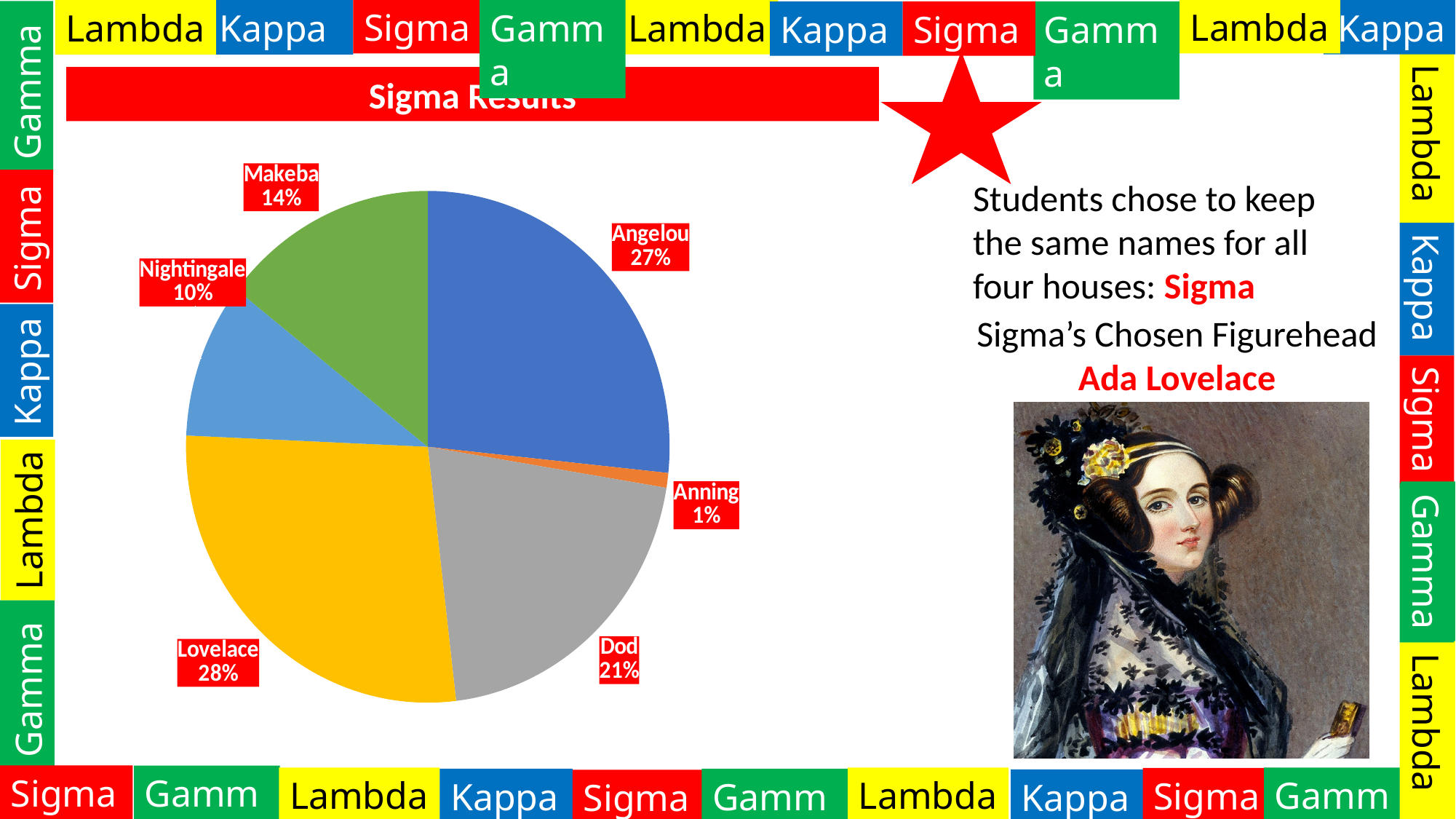
What is the title of the chart? Sigma Results Which is larger, the share for Dod or the share for Makeba? Dod Which slice of the pie is the largest? Lovelace What kind of chart is shown on the slide? pie chart Which slice of the pie is the smallest? Anning What is the combined share of Angelou and Dod? 48% What is the value shown for Dod? 21% What share of the pie does Angelou have? 27% What share of the pie does Lovelace have? 28% What is the difference between the Makeba and Nightingale percentages? 4% How many slices does the pie chart have? 6 What is the value shown for Nightingale? 10%